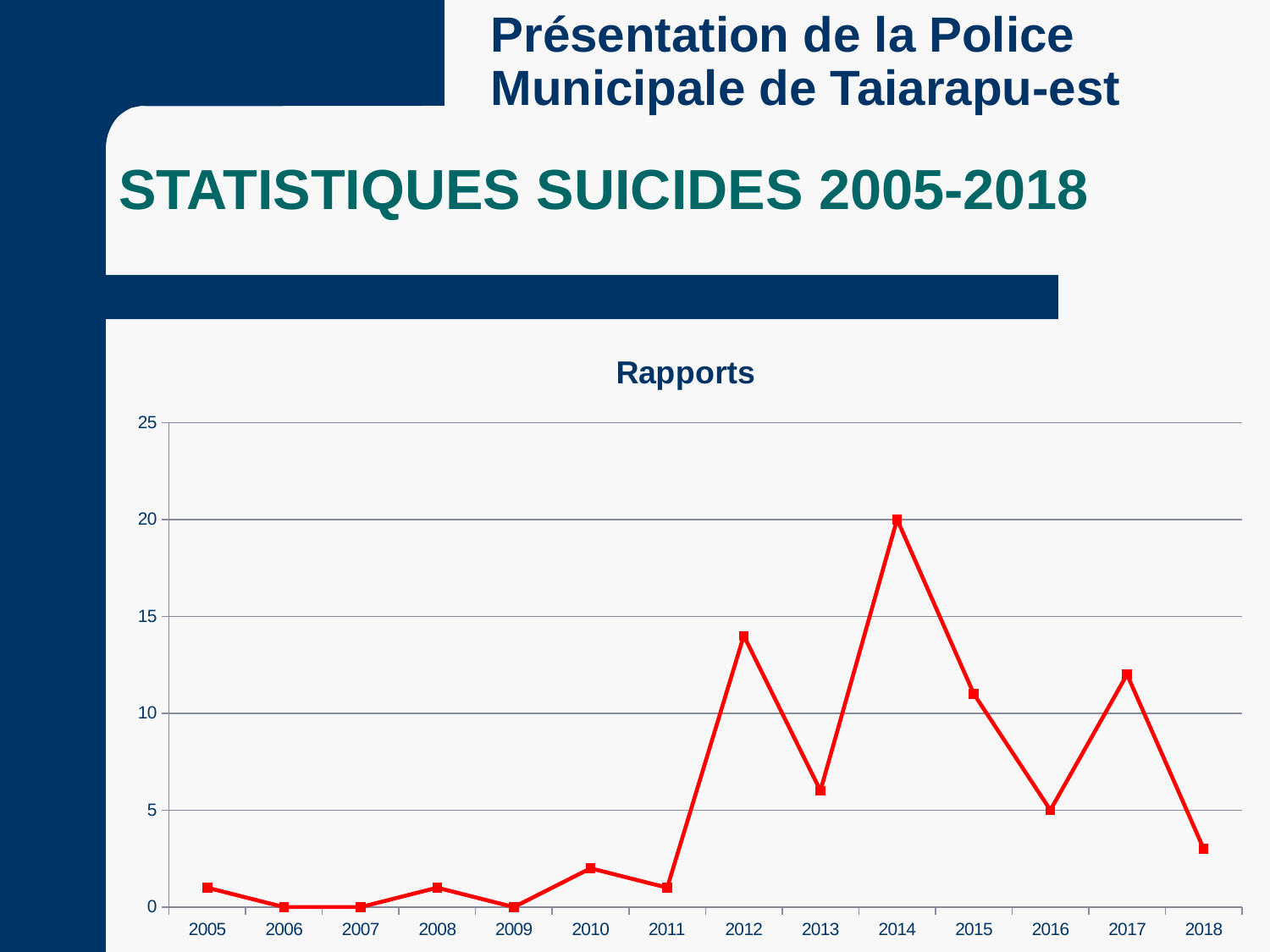
Which is larger, the value for 2012 or the value for 2013? 2012 What is the title of the chart? Rapports How many years are plotted on the x axis of the chart? 14 Do the values rise or fall from 2014 to 2016? fall What is the value for 2014? 20 What kind of chart is shown on the slide? line chart What is the value for 2006? 0 Is the value for 2012 greater or less than 10? greater Which year has the highest value in the chart? 2014 Is the value for 2015 greater or less than 10? greater What is the value for 2016? 5 Is the value for 2018 greater or less than 5? less